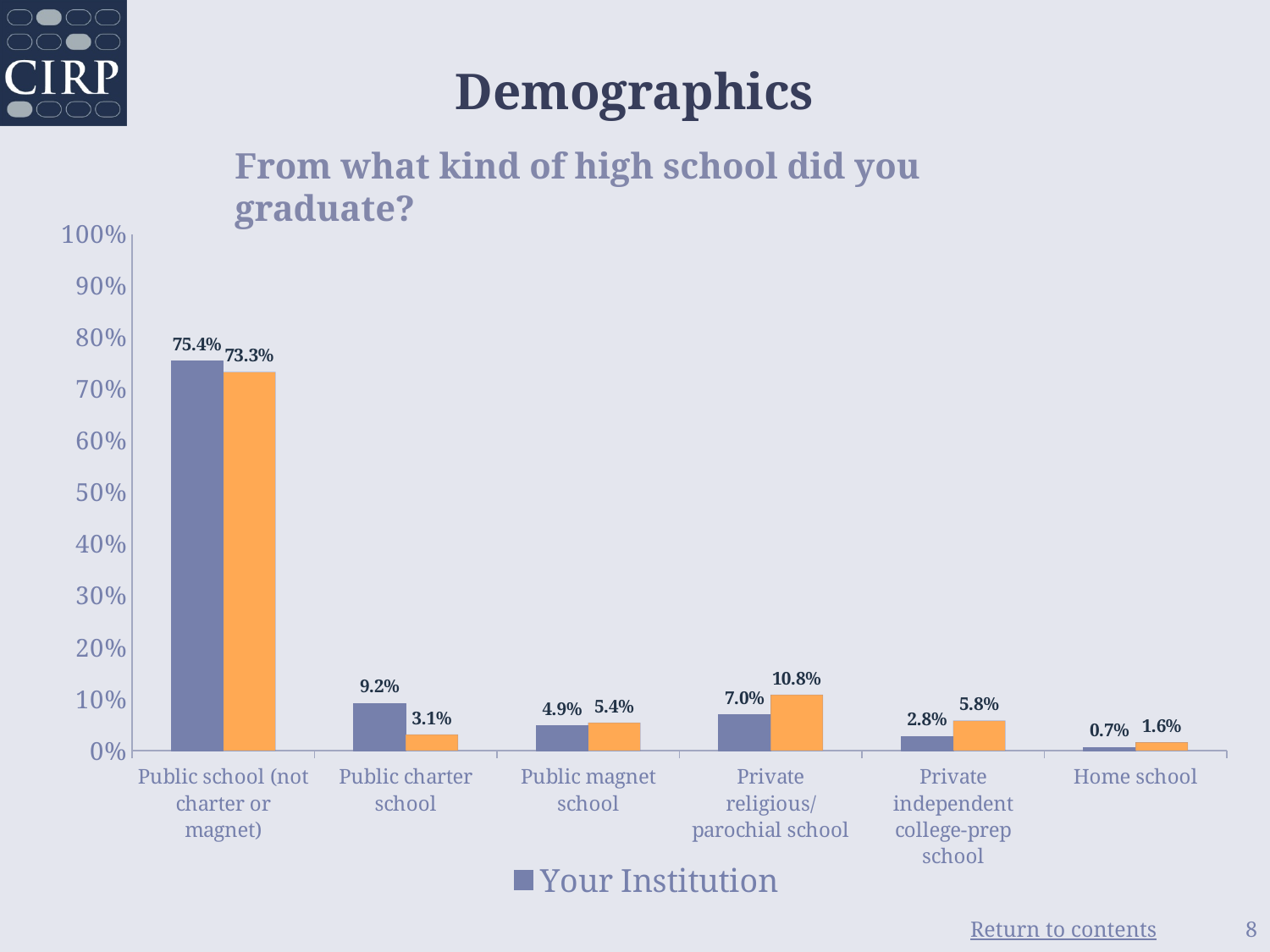
What is the Your Institution value for Public charter school? 9.2% What is the value of the orange bar for Private religious/parochial school? 10.8% What is the title of the chart? From what kind of high school did you graduate? What is the Your Institution value for Home school? 0.7% For Public charter school, which is larger: the Your Institution bar or the orange bar? Your Institution Which category has the highest Your Institution value? Public school (not charter or magnet) What is the difference between the Your Institution value and the orange bar value for Public school (not charter or magnet)? 2.1% How many high school categories are shown on the x axis? 6 What is the difference between the orange bar value and the Your Institution value for Private religious/parochial school? 3.8% What kind of chart is shown on the slide? bar chart Which category has the lowest Your Institution value? Home school Is the Your Institution value for Public school (not charter or magnet) greater or less than 70%? greater